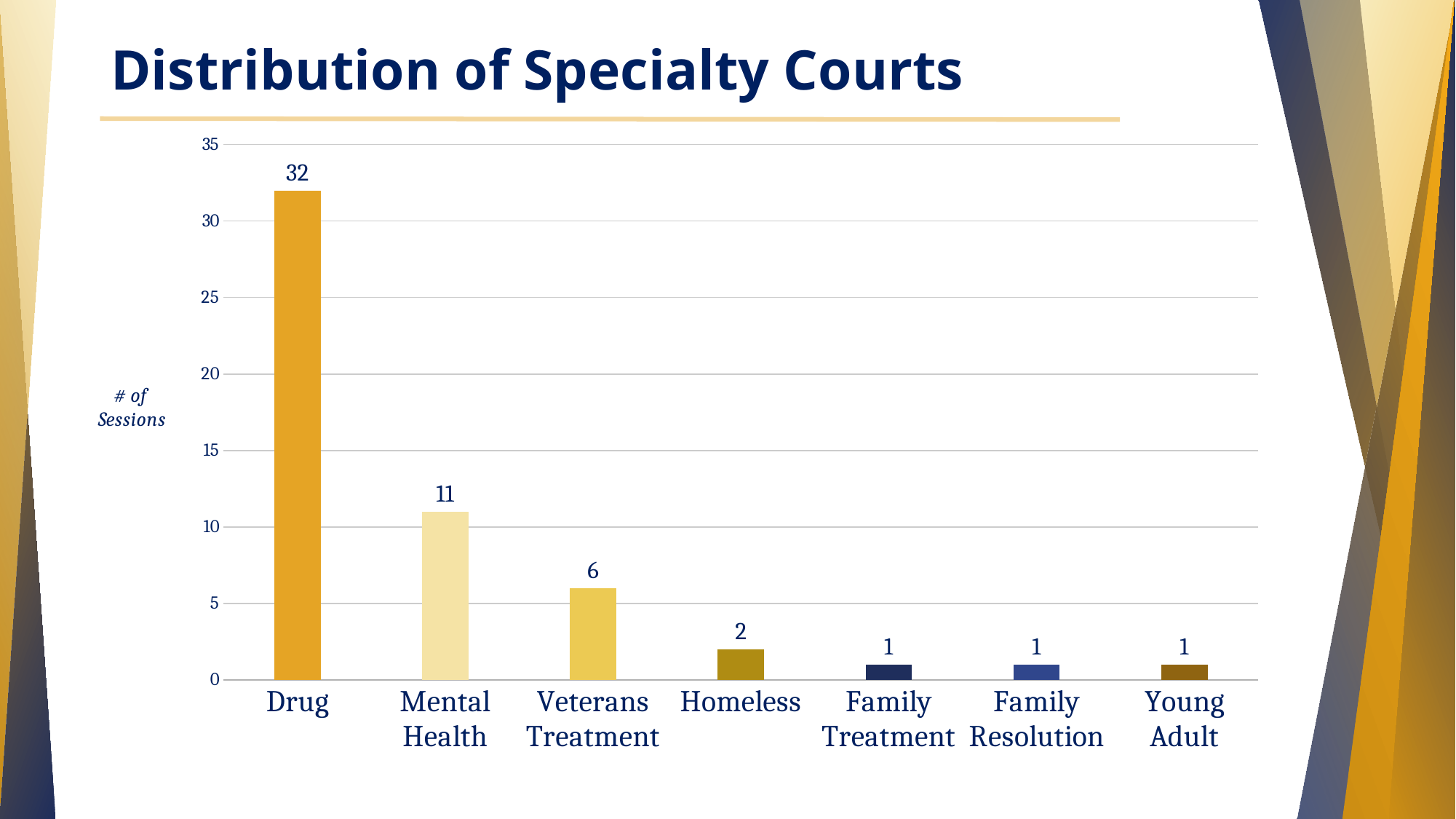
What is the difference in sessions between Mental Health and Veterans Treatment courts? 5 What is the number of sessions for Drug courts? 32 What is the title of the chart? Distribution of Specialty Courts What is the number of sessions for Veterans Treatment courts? 6 How many categories are shown on the x axis? 7 Which category has the highest number of sessions? Drug What is the number of sessions for Homeless courts? 2 What kind of chart is shown on the slide? bar chart Which has more sessions, Veterans Treatment or Homeless? Veterans Treatment What is the difference in sessions between Drug and Mental Health courts? 21 What is the number of sessions for Mental Health courts? 11 Is the value for Drug greater or less than 30? greater